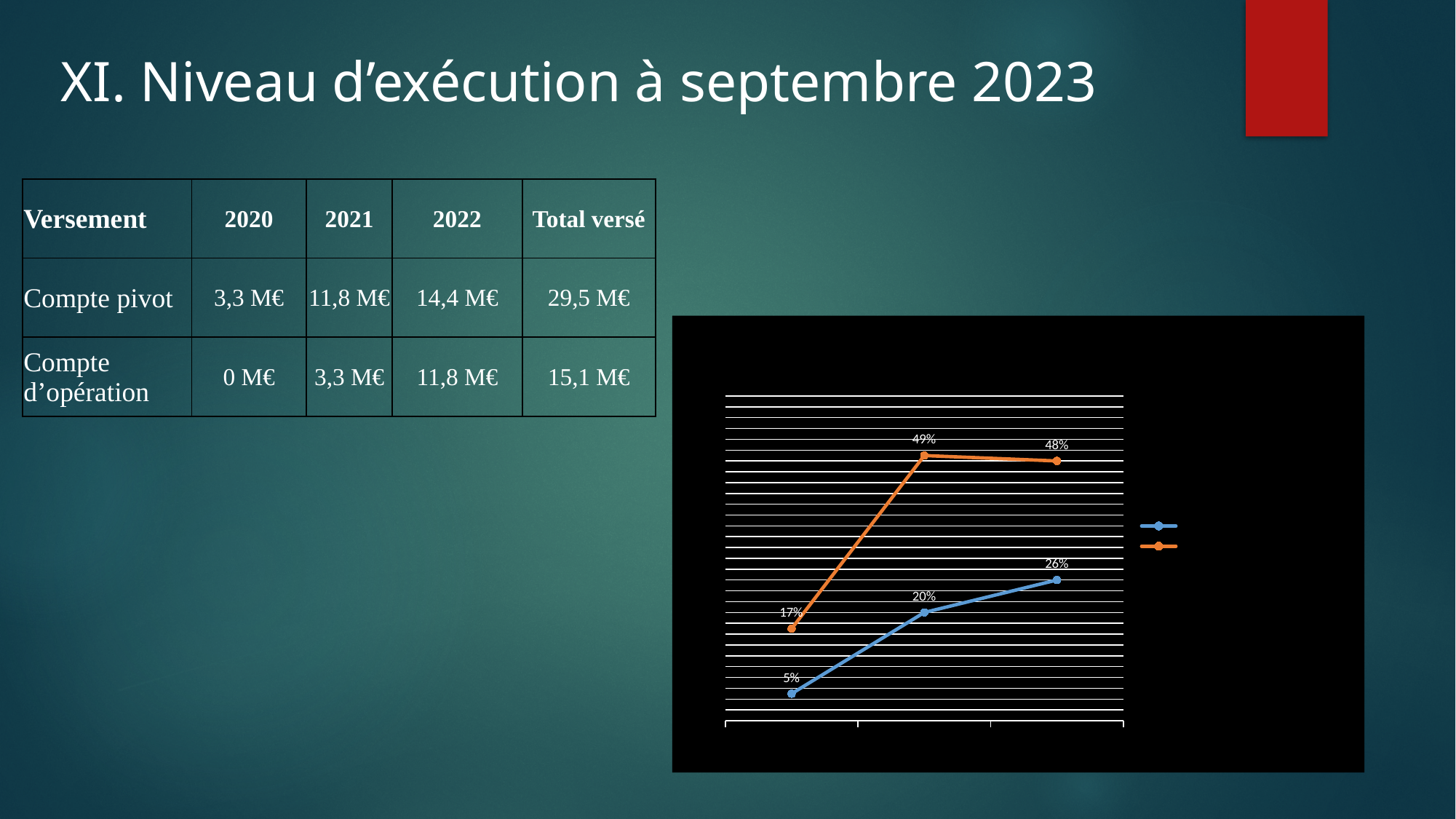
How many data points does the blue line have? 3 What is the value of the last (rightmost) point on the blue line? 26% What is the difference between the first point of the orange line and the first point of the blue line? 12 percentage points How many series does the chart's legend list? 2 What is the value of the last (rightmost) point on the orange line? 48% What is the highest value on the orange line? 49% What is the value of the second point on the orange line? 49% What is the lowest value on the blue line? 5% What kind of chart is shown on the slide? line chart At the second point, which line has the larger value, the blue or the orange? orange Does the blue line rise or fall from left to right? rise What is the value of the first (leftmost) point on the blue line? 5%